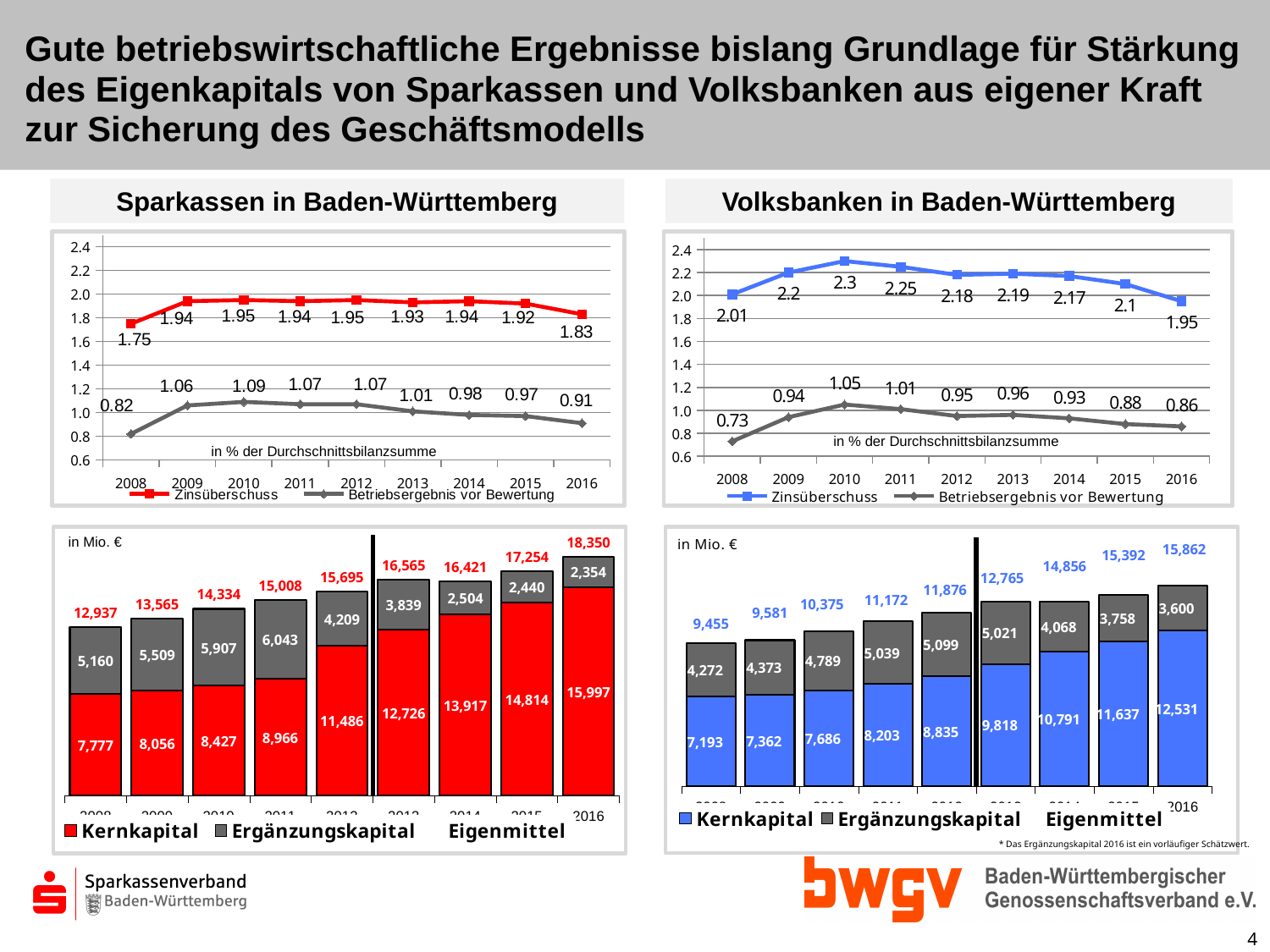
In the Sparkassen in Baden-Württemberg bar chart (bottom left), what is the Kernkapital value for 2012? 11,486 In the Volksbanken in Baden-Württemberg bar chart (bottom right), which is larger in 2016: Kernkapital or Ergänzungskapital? Kernkapital In the Sparkassen in Baden-Württemberg line chart (top left), how does Betriebsergebnis vor Bewertung develop from 2010 to 2016? It falls In the Volksbanken in Baden-Württemberg line chart (top right), what is the difference between Zinsüberschuss and Betriebsergebnis vor Bewertung in 2016? 1.09 In the Volksbanken in Baden-Württemberg line chart (top right), in which year is Zinsüberschuss highest? 2010 In the Volksbanken in Baden-Württemberg line chart (top right), what is the Betriebsergebnis vor Bewertung value for 2008? 0.73 In the Sparkassen in Baden-Württemberg bar chart (bottom left), what is the Eigenmittel total for 2016? 18,350 In the Sparkassen in Baden-Württemberg line chart (top left), in which year is Betriebsergebnis vor Bewertung lowest? 2008 In the Volksbanken in Baden-Württemberg bar chart (bottom right), what is the Ergänzungskapital value for 2011? 5,039 What type of chart is the bottom-right Volksbanken in Baden-Württemberg chart? Stacked bar chart How many years are shown on the x axis of the Sparkassen in Baden-Württemberg bar chart (bottom left)? 9 In the Sparkassen in Baden-Württemberg line chart (top left), what is the Zinsüberschuss value for 2010? 1.95